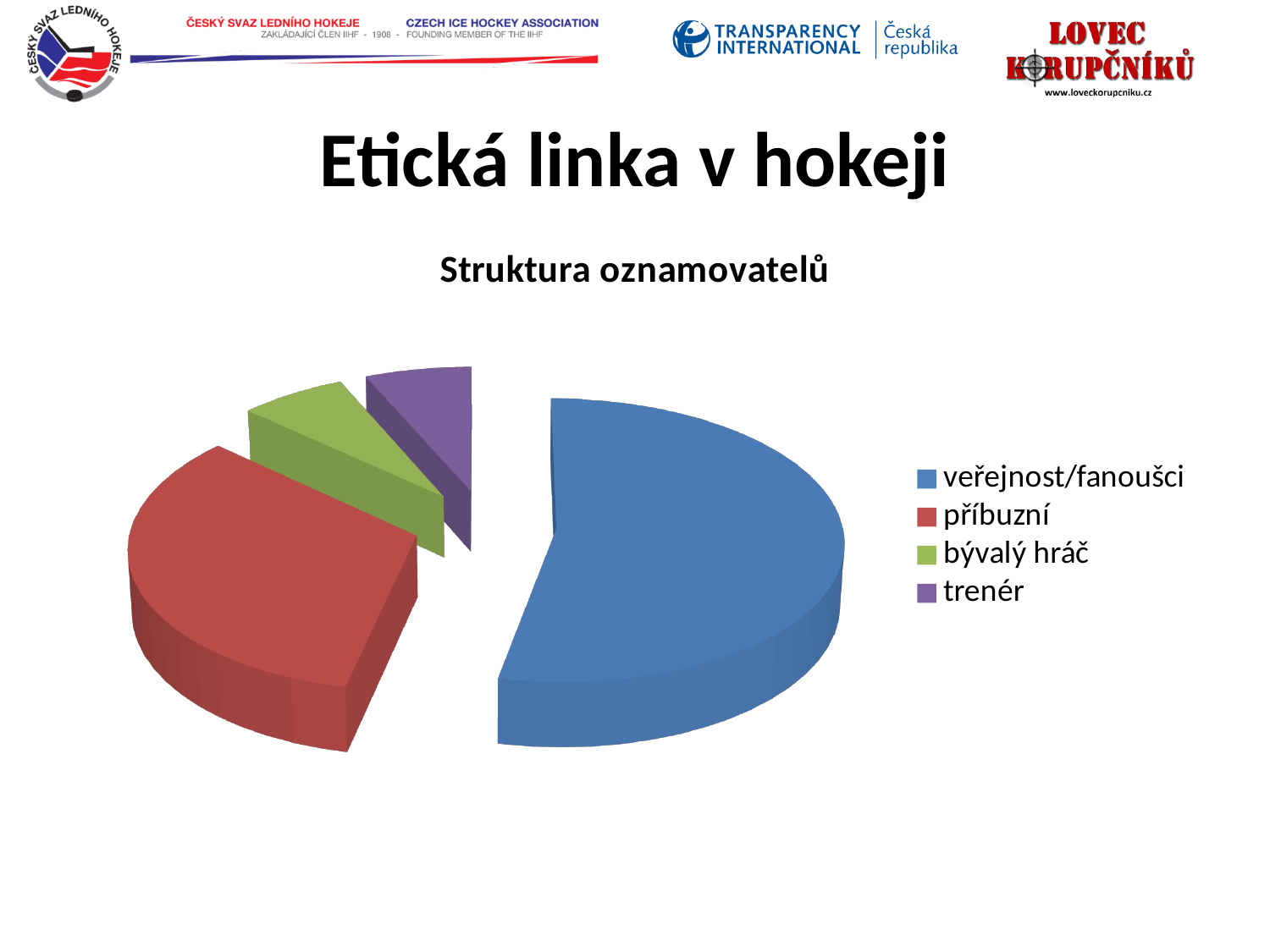
Which slice is larger, veřejnost/fanoušci or příbuzní? veřejnost/fanoušci Which colour represents příbuzní in the pie chart? red What is the title of the chart? Struktura oznamovatelů Which category has the largest slice of the pie? veřejnost/fanoušci Which slice is larger, příbuzní or bývalý hráč? příbuzní How many categories does the pie chart have? 4 Which category is shown in blue? veřejnost/fanoušci What kind of chart is shown on the slide? pie chart